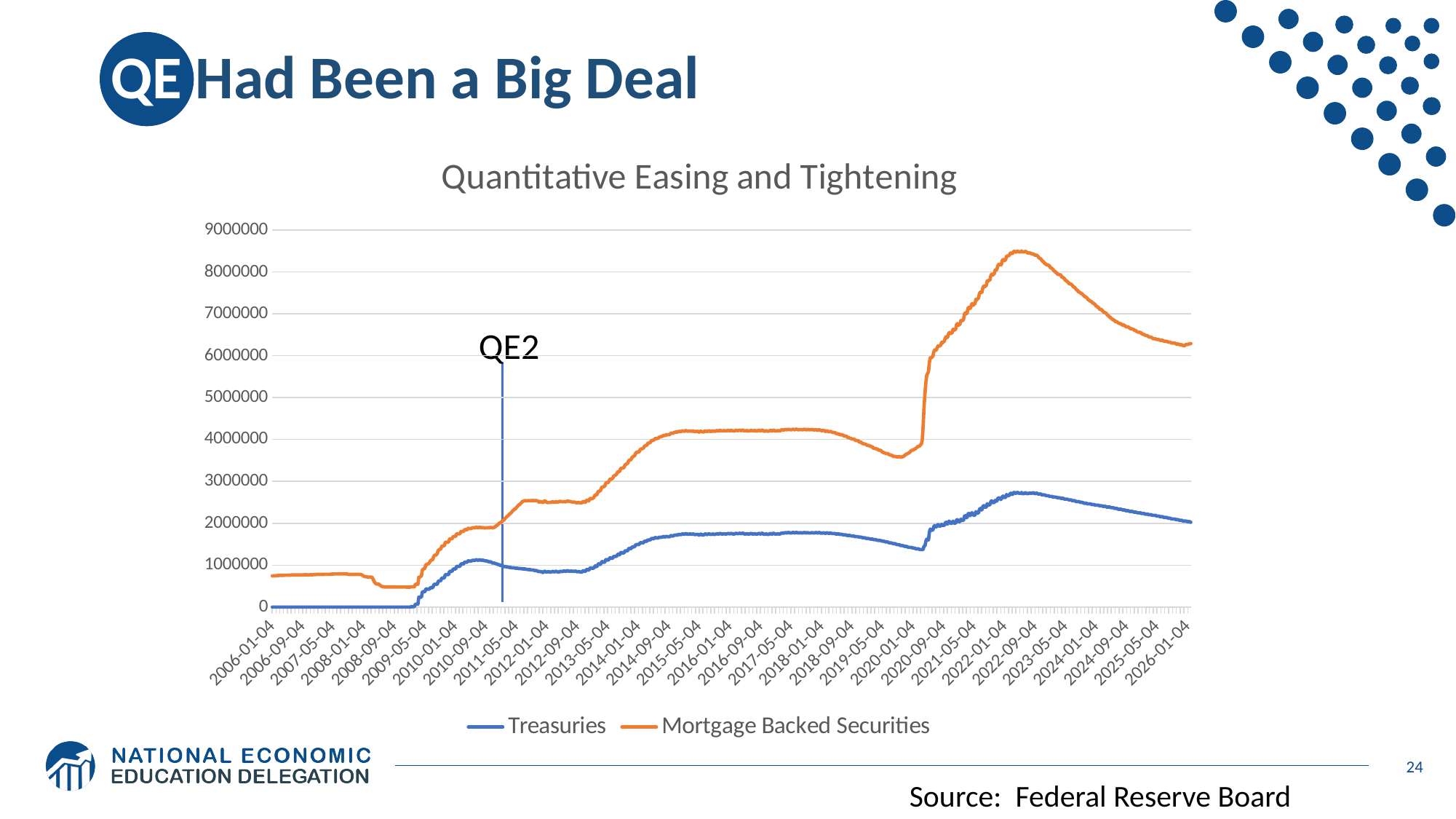
Which series is larger at 2022-01-04, Treasuries or Mortgage Backed Securities? Mortgage Backed Securities What label is attached to the vertical marker line on the chart? QE2 Does the Mortgage Backed Securities line rise or fall between 2022-09-04 and 2026-01-04? Fall Is the value of Mortgage Backed Securities at 2006-01-04 greater or less than 1000000? less Which series reaches the highest value on the chart? Mortgage Backed Securities Is the value of Treasuries at 2016-01-04 greater or less than 2000000? less What is the title of the chart? Quantitative Easing and Tightening Is the value of Mortgage Backed Securities at 2026-01-04 greater or less than 6000000? greater What kind of chart is shown on the slide? Line chart How many series does the legend list? 2